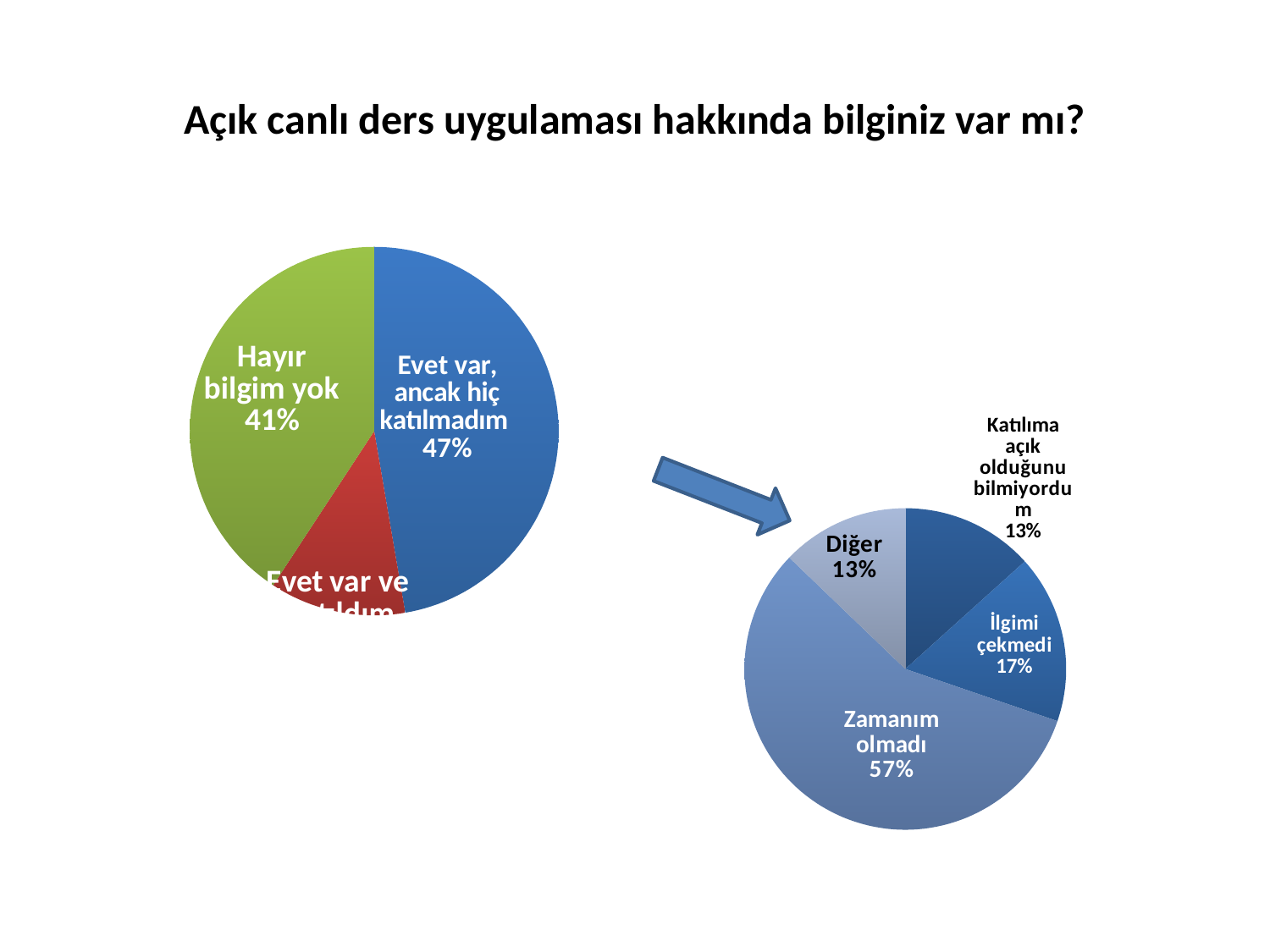
In the right pie chart, which is larger: "İlgimi çekmedi" or "Diğer"? İlgimi çekmedi What type of chart is shown on the right of the slide? Pie chart In the left pie chart, what share is labelled for "Hayır bilgim yok"? 41% In the right pie chart, what share is labelled for "Zamanım olmadı"? 57% In the left pie chart, which labelled slice is the largest? Evet var, ancak hiç katılmadım In the left pie chart, which slice is the smallest? Evet var ve katıldım In the right pie chart, which slice is the largest? Zamanım olmadı How many slices does the left pie chart have? 3 In the right pie chart, what share is labelled for "İlgimi çekmedi"? 17% In the left pie chart, what is the difference between the shares for "Evet var, ancak hiç katılmadım" and "Hayır bilgim yok"? 6% In the right pie chart, what share is labelled for "Diğer"? 13% In the left pie chart, what share is labelled for "Evet var, ancak hiç katılmadım"? 47%